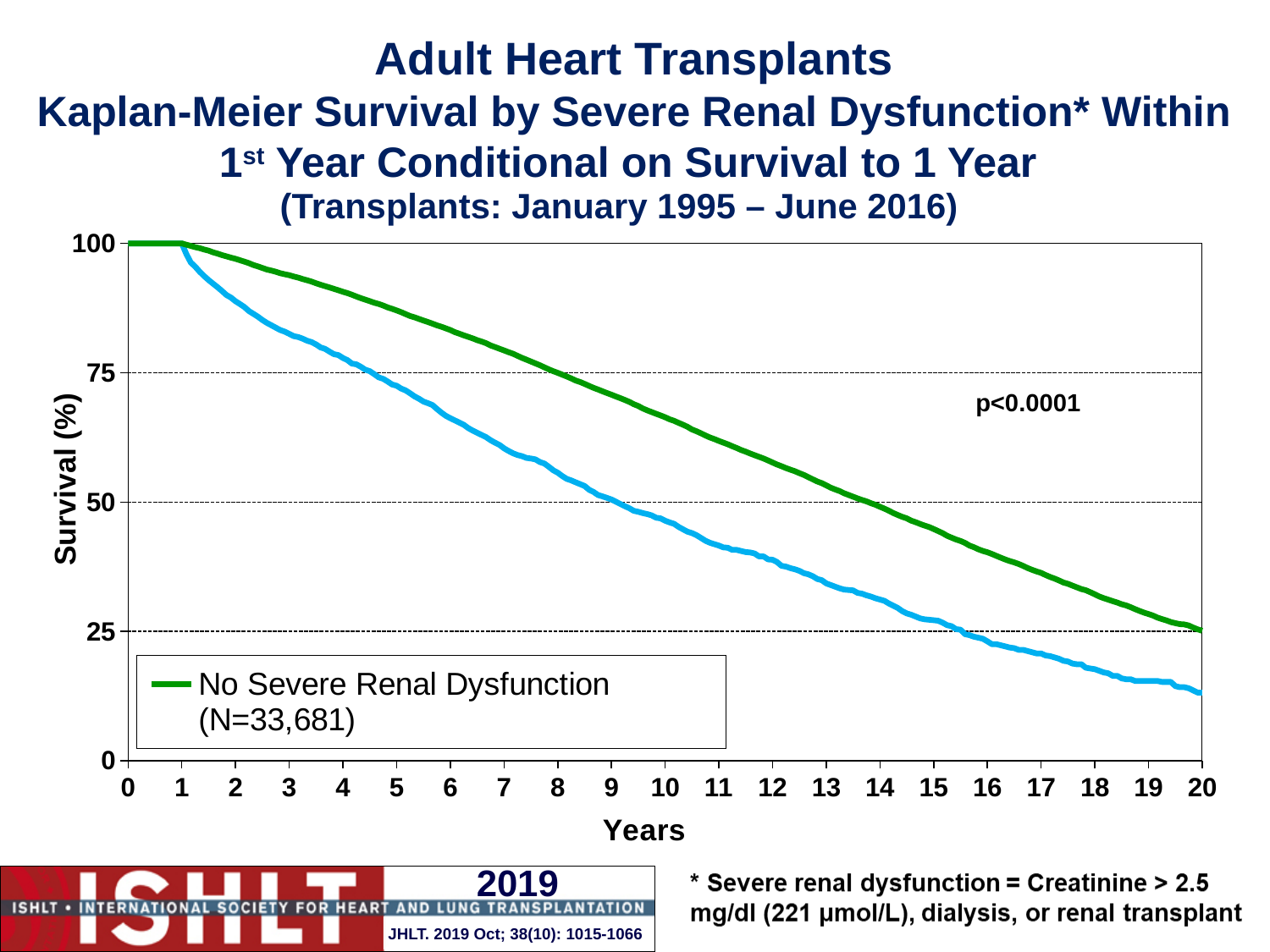
Is the survival value for No Severe Renal Dysfunction at year 15 greater or less than 50? less How many series does the legend list? 1 What is the p-value printed on the chart? p<0.0001 What is the series named in the legend? No Severe Renal Dysfunction (N=33,681) What kind of chart is shown on the slide? Line chart Is the survival value for No Severe Renal Dysfunction at year 10 greater or less than 50? greater Is the survival value of the blue line at year 3 greater or less than 75? greater Does survival for No Severe Renal Dysfunction rise or fall as years increase? Fall At year 10, which line shows higher survival, the green line or the blue line? The green line What is the maximum value shown on the x axis (Years)? 20